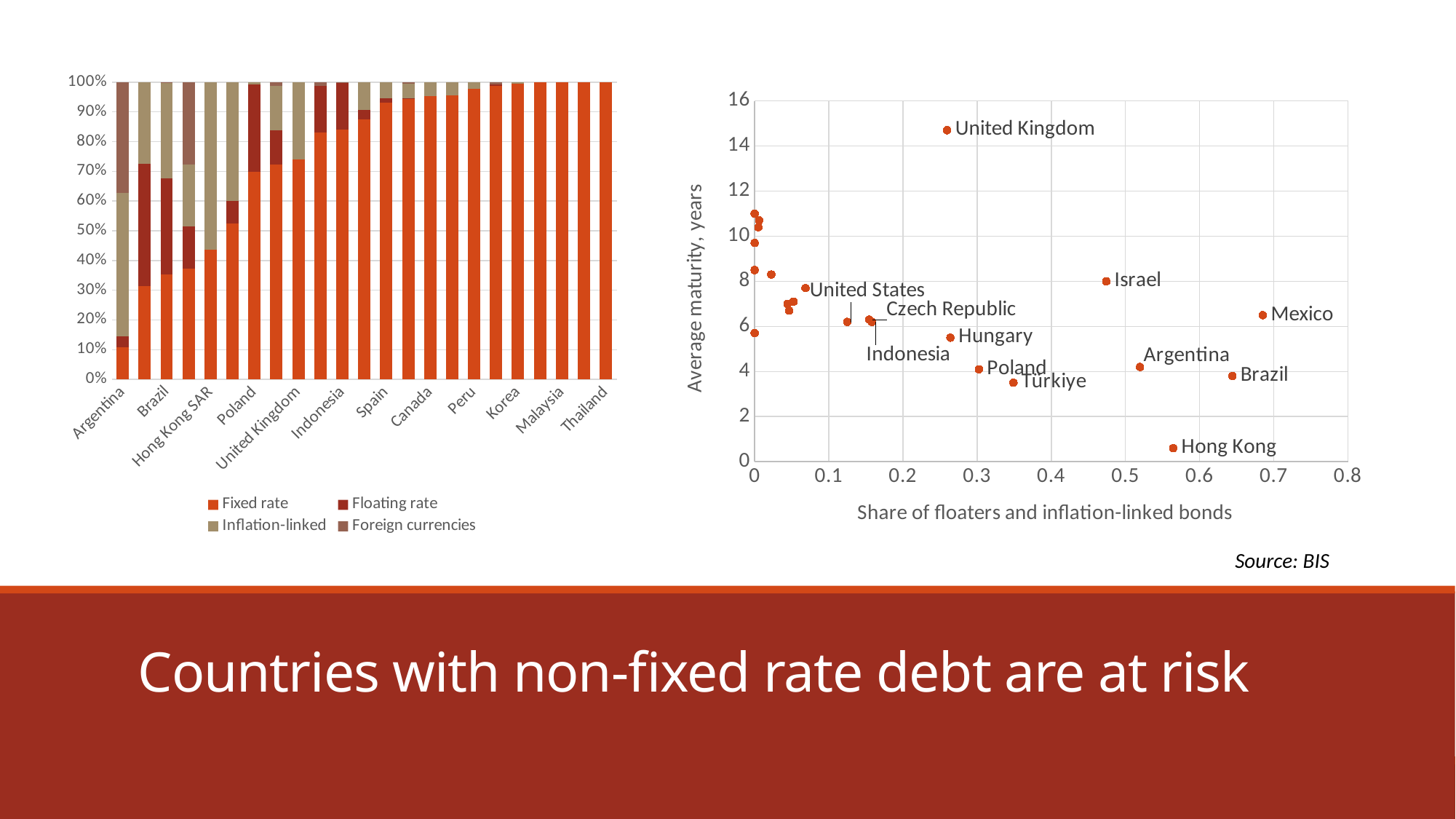
In the right chart, which labelled country has the lowest average maturity? Hong Kong In the right chart, is the average maturity for Hong Kong greater or less than 2 years? less How many series does the legend of the left chart list? 4 What kind of chart is the chart on the left of the slide? Bar chart What is the label of the horizontal axis of the right chart? Share of floaters and inflation-linked bonds In the right chart, which country has the highest average maturity? United Kingdom In the left chart, is the Fixed rate share for Thailand greater or less than 90%? greater In the left chart, is the Fixed rate share for Argentina greater or less than 20%? less What kind of chart is the chart on the right of the slide? Scatter plot In the right chart, which labelled country has the highest share of floaters and inflation-linked bonds? Mexico In the right chart, which has a higher average maturity, Israel or Brazil? Israel In the left chart, does the Fixed rate share rise or fall moving from left to right across the countries? rise